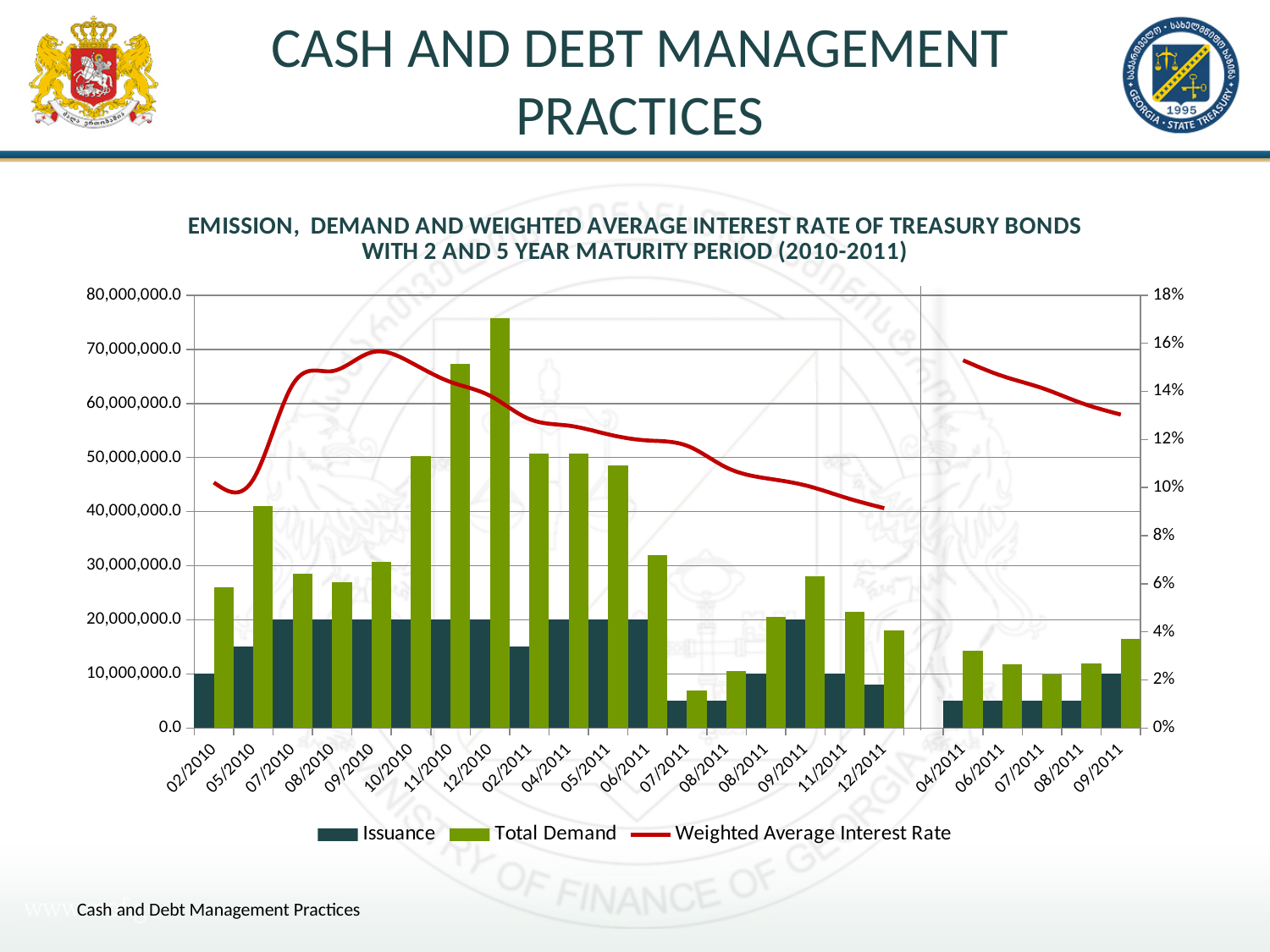
Does the Weighted Average Interest Rate rise or fall from 09/2010 to 12/2011? Fall What is the title of the chart? EMISSION, DEMAND AND WEIGHTED AVERAGE INTEREST RATE OF TREASURY BONDS WITH 2 AND 5 YEAR MATURITY PERIOD (2010-2011) What is the Issuance value for 07/2010? 20,000,000.0 Is the Total Demand for 11/2010 greater or less than 60,000,000.0? greater Which is larger, Total Demand for 12/2010 or Total Demand for 11/2010? 12/2010 Is the Total Demand for 12/2010 greater or less than 70,000,000.0? greater What is the Issuance value for 02/2010? 10,000,000.0 In which month is Total Demand highest? 12/2010 Is the Weighted Average Interest Rate for 09/2010 greater or less than 14%? greater What kind of chart is shown on the slide? A combination bar and line chart How many series does the legend list? 3 Which series is drawn as a red line? Weighted Average Interest Rate